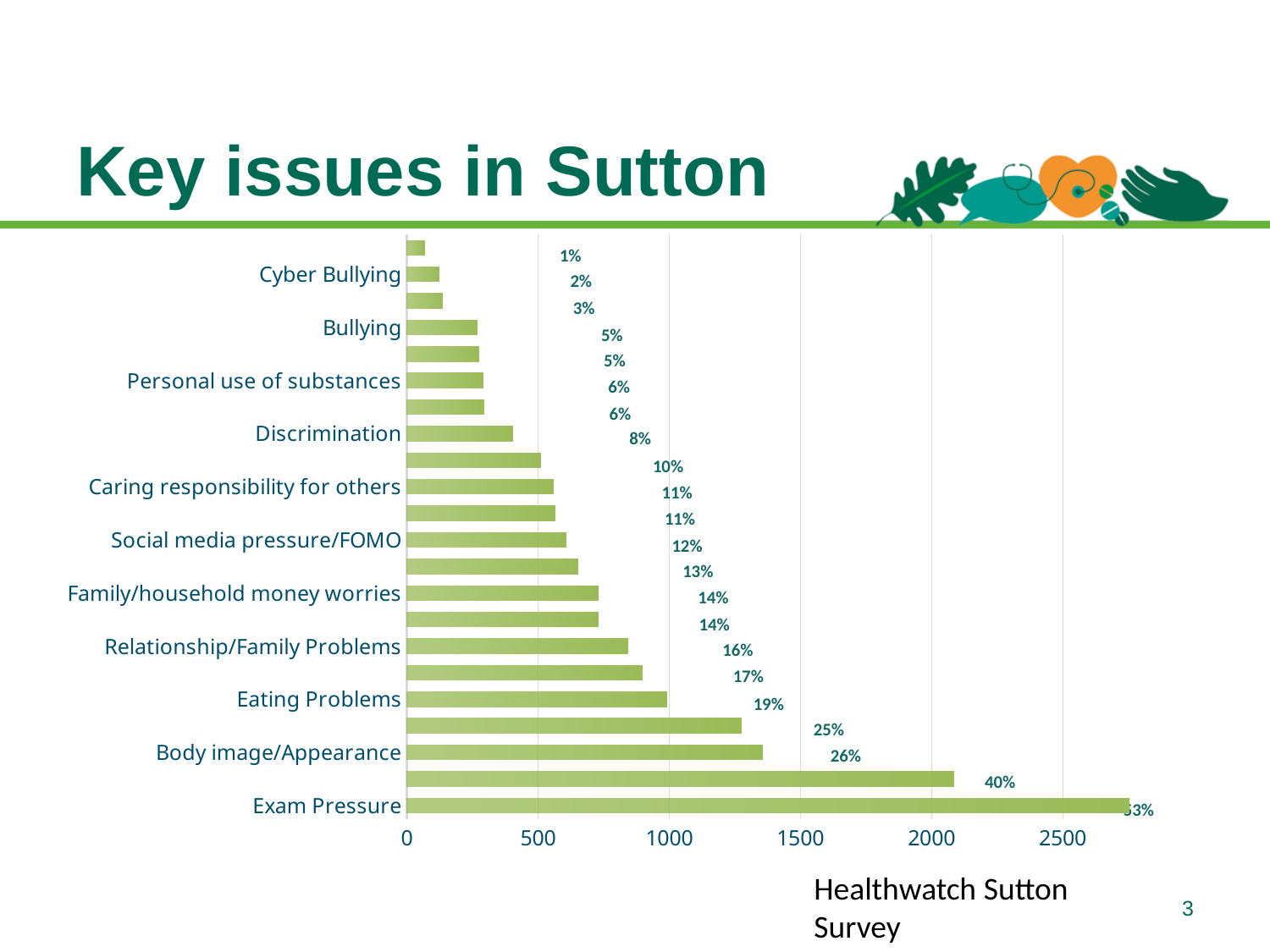
What kind of chart is shown on the slide? bar chart Which issue has the highest value in the chart? Exam Pressure Is the bar for Body image/Appearance greater or less than 1500 on the axis? less What source is cited below the chart? Healthwatch Sutton Survey What percentage is shown for Cyber Bullying? 2% What percentage is shown for Family/household money worries? 14% Which is larger, the value for Bullying or the value for Social media pressure/FOMO? Social media pressure/FOMO What percentage is shown for Eating Problems? 19% Is the bar for Exam Pressure greater or less than 2500 on the axis? greater What percentage is shown for Body image/Appearance? 26% What is the difference in percentage points between Body image/Appearance and Eating Problems? 7% What percentage is shown for Discrimination? 8%